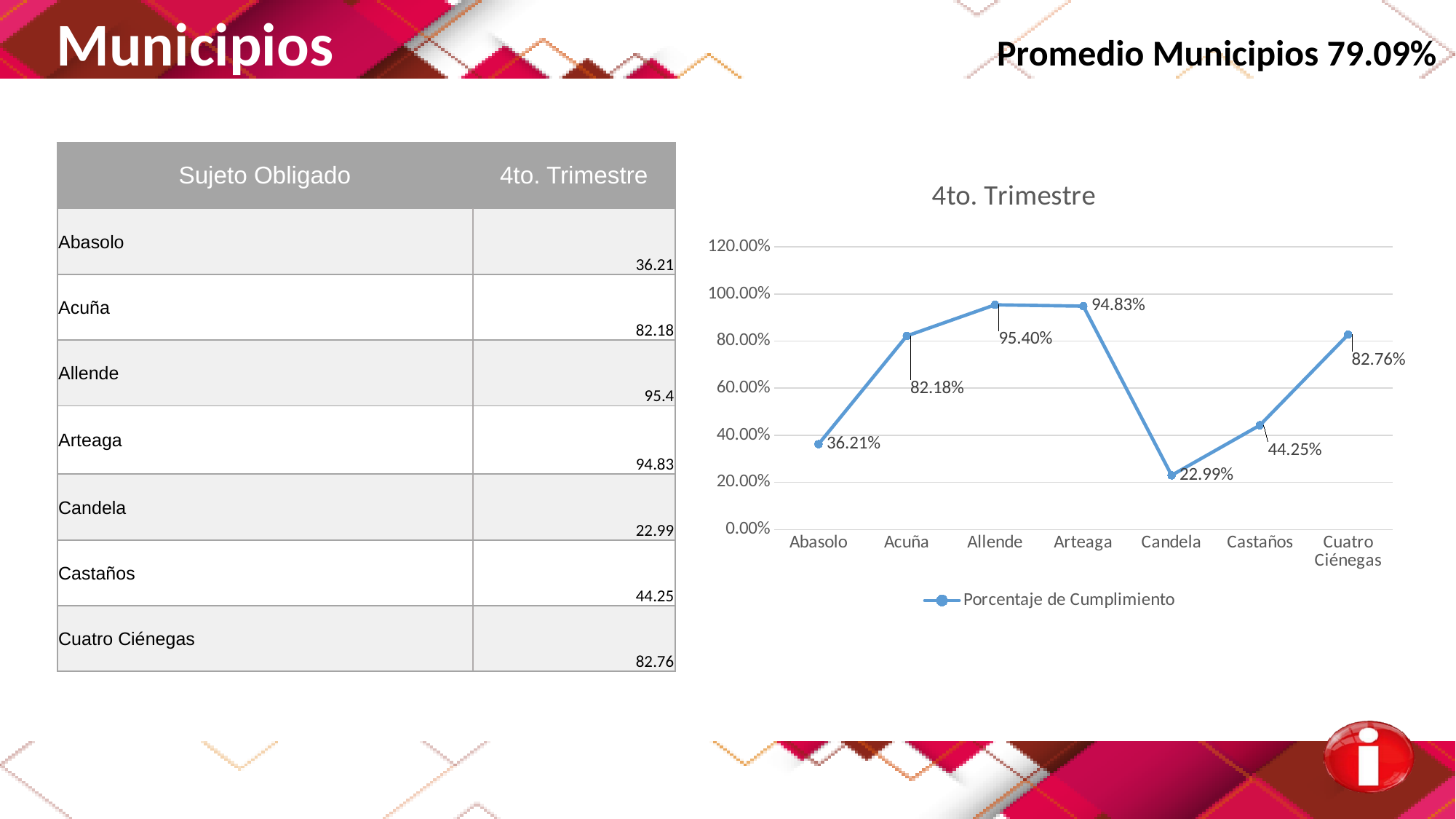
How many series does the chart legend list? 1 Which municipality has the highest value in the chart? Allende Which is larger, the value for Castaños or the value for Cuatro Ciénegas? Cuatro Ciénegas What is the value for Abasolo in the chart? 36.21% What is the value for Candela in the chart? 22.99% What is the difference between the values for Acuña and Abasolo? 45.97% What is the difference between the values for Allende and Arteaga? 0.57% Which municipality has the lowest value in the chart? Candela What is the value for Cuatro Ciénegas in the chart? 82.76% What is the title of the chart? 4to. Trimestre How many municipalities are plotted on the x axis of the chart? 7 What kind of chart is shown on the slide? line chart